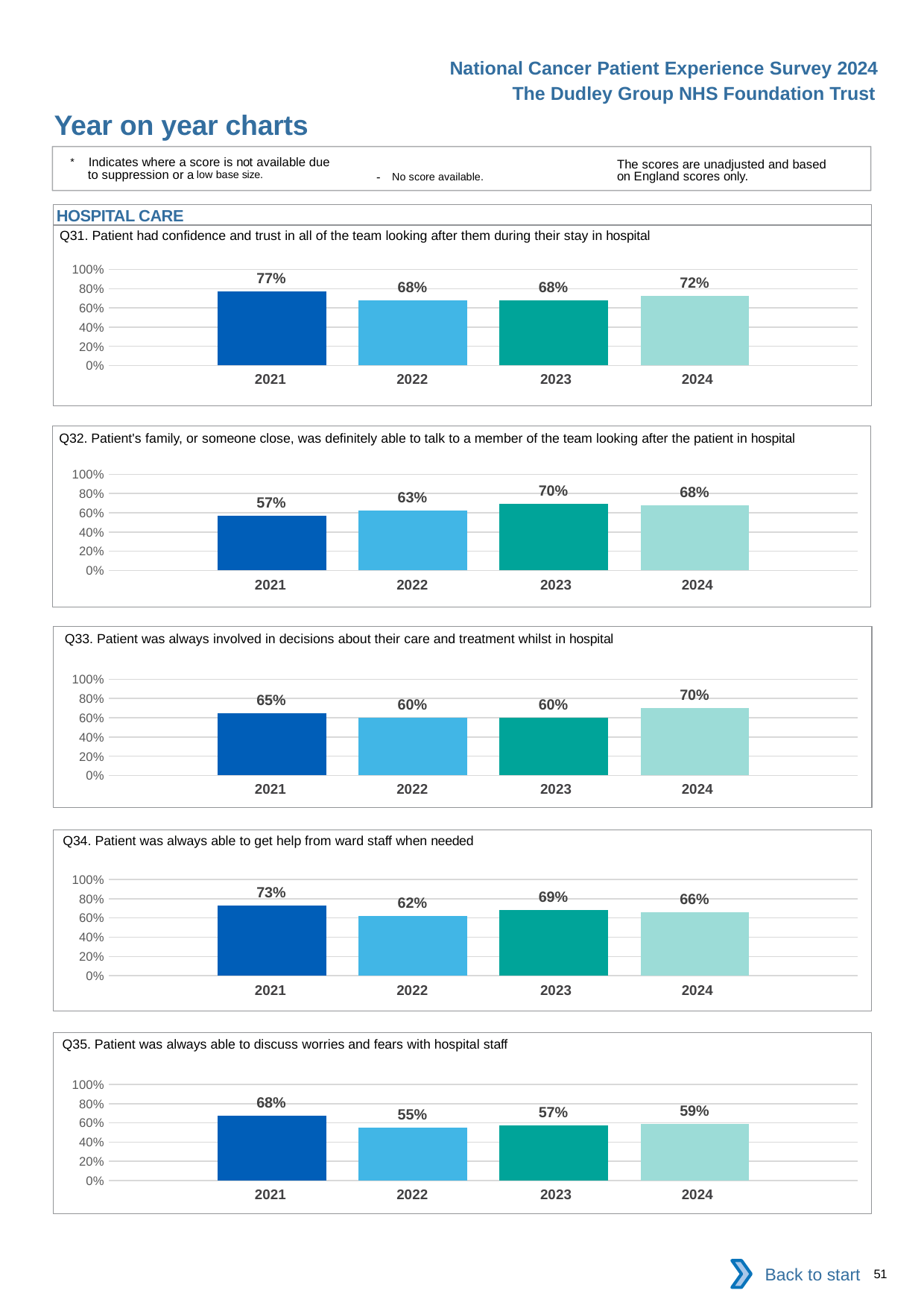
In the Q34 chart, which is larger, the value for 2022 or the value for 2023? 2023 In the Q32 chart, which year has the lowest value? 2021 In the Q34 chart, what is the difference between the 2021 value and the 2022 value? 11% In the Q32 chart, which year has the highest value? 2023 In the Q31 chart, what is the value for 2021? 77% In the Q35 chart, what is the value for 2022? 55% In the Q35 chart, which year has the highest value? 2021 How many charts are shown on the slide? 5 What kind of chart is the Q34 chart? bar chart How many years are shown in the Q31 chart? 4 In the Q32 chart, is the value for 2024 greater or less than 60%? greater In the Q33 chart, what is the difference between the 2024 value and the 2021 value? 5%